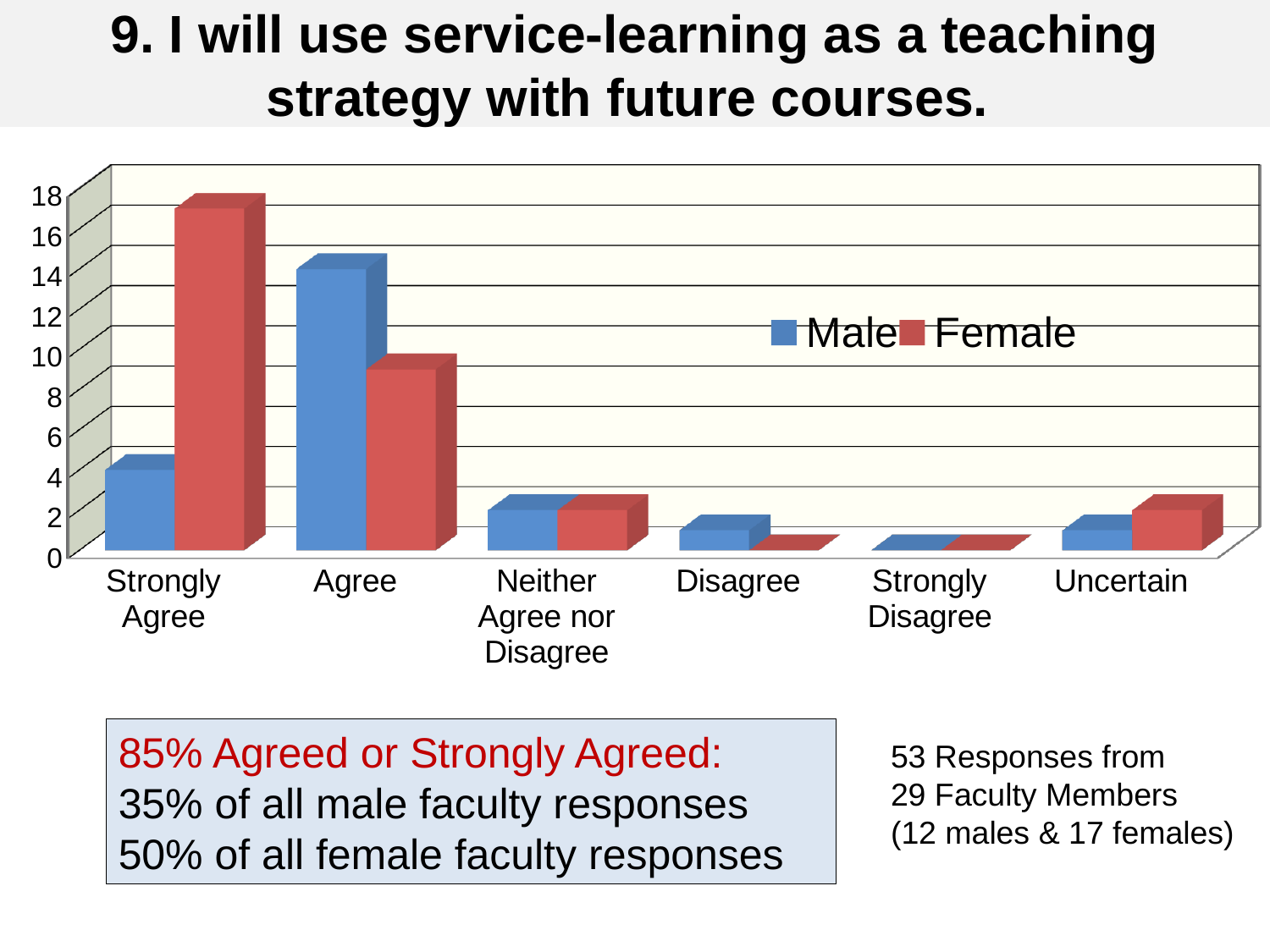
Is the Female value for Agree greater or less than 8? greater Which category has the highest Male value? Agree Is the Male value for Agree greater or less than 12? greater Which category has the highest Female value? Strongly Agree How many series does the legend list? 2 Is the Female value for Strongly Agree greater or less than 16? greater Which colour represents the Female series in the chart? red For Agree, which is larger, the Male value or the Female value? Male What kind of chart is shown on the slide? bar chart How many response categories are shown on the x axis? 6 For Strongly Agree, which is larger, the Male value or the Female value? Female